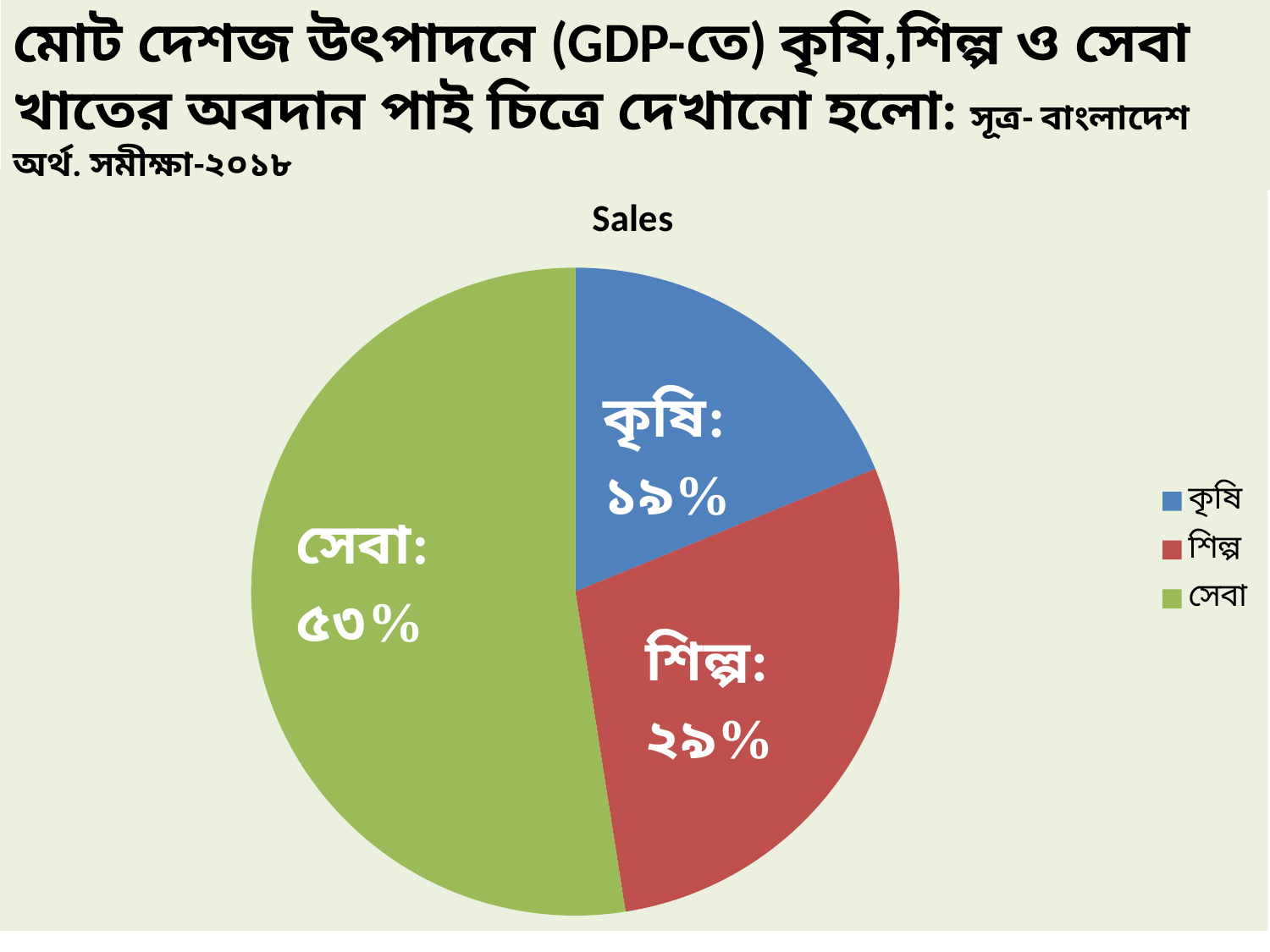
How many slices does the pie chart have? 3 What share of the pie is labelled for কৃষি? ১৯% What share of the pie is labelled for সেবা? ৫৩% By how many percentage points does the share for সেবা exceed the share for কৃষি? ৩৪% Which sector has the largest slice of the pie? সেবা Which is larger, the share for শিল্প or the share for কৃষি? শিল্প What kind of chart is shown on the slide? pie chart What is the title of the chart? Sales How many entries does the legend list? 3 Which sector has the smallest slice of the pie? কৃষি What colour is the slice for সেবা? green What share of the pie is labelled for শিল্প? ২৯%